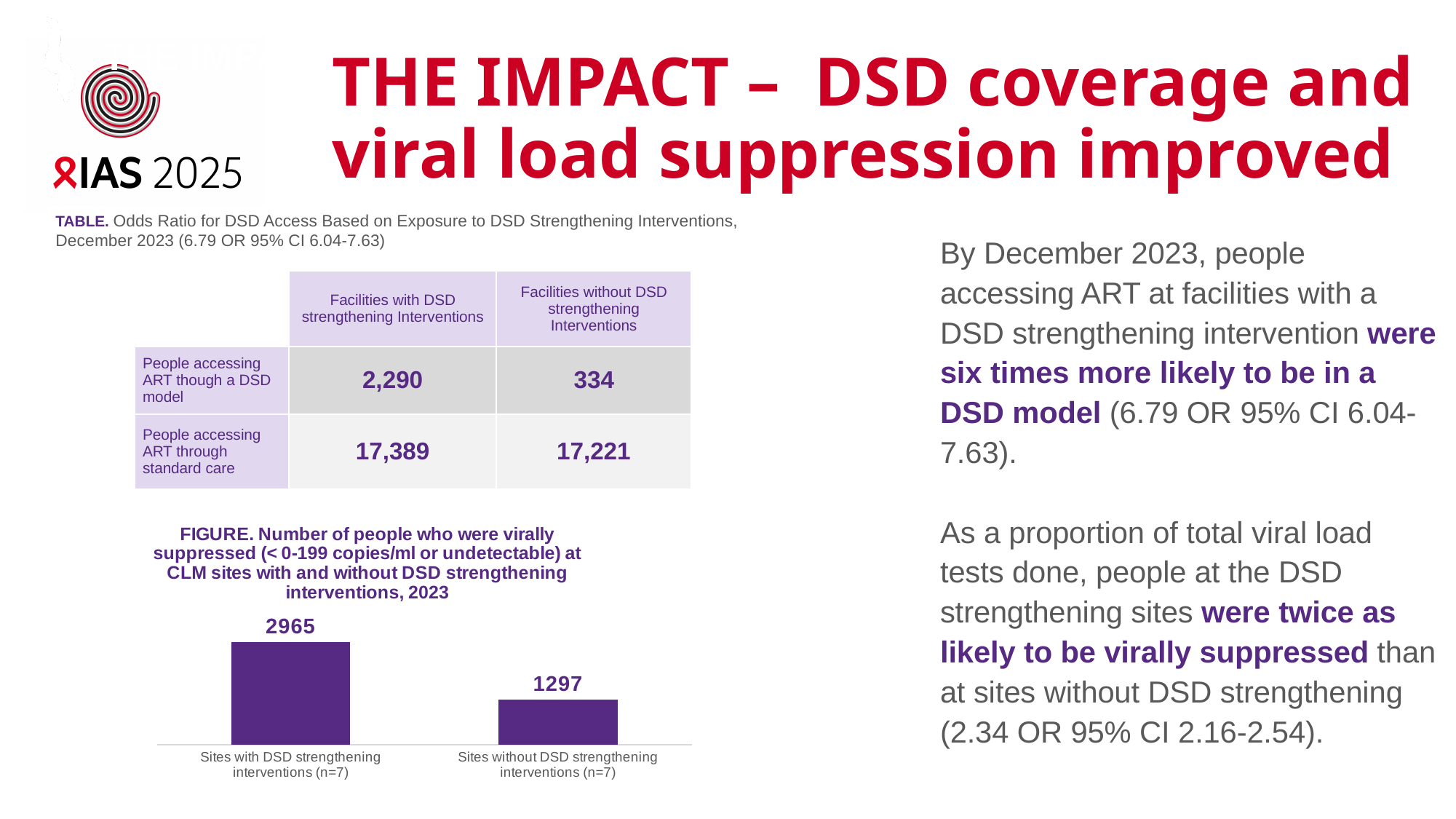
In the bar chart, what is the number of people who were virally suppressed at sites with DSD strengthening interventions (n=7)? 2965 What is the total number of virally suppressed people across both categories in the bar chart? 4262 What colour are the bars in the bar chart? purple What year is stated in the title of the bar chart? 2023 In the bar chart, which category has the higher number of virally suppressed people? Sites with DSD strengthening interventions (n=7) In the bar chart, which category has the lower number of virally suppressed people? Sites without DSD strengthening interventions (n=7) How many bars are shown in the bar chart? 2 What type of chart is the figure at the bottom left of the slide? bar chart In the bar chart, is the value for sites with DSD strengthening interventions larger or smaller than the value for sites without DSD strengthening interventions? larger In the bar chart, what is the number of people who were virally suppressed at sites without DSD strengthening interventions (n=7)? 1297 In the bar chart, what is the difference between the number of virally suppressed people at sites with and without DSD strengthening interventions? 1668